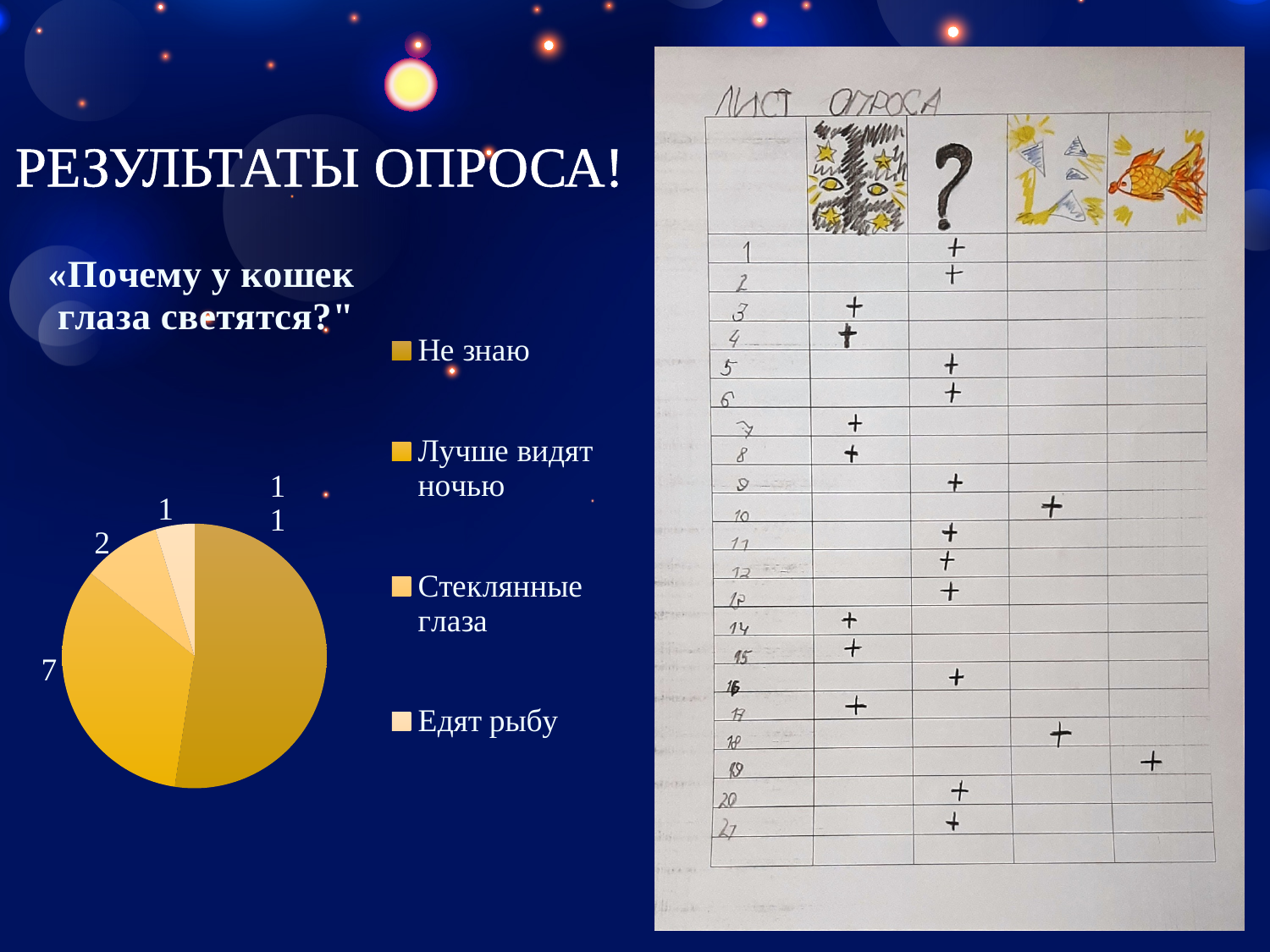
How many slices does the pie chart have? 4 What is the value for "Стеклянные глаза" in the pie chart? 2 What survey question is the pie chart about? «Почему у кошек глаза светятся?» What is the difference between the values for "Лучше видят ночью" and "Стеклянные глаза"? 5 What kind of chart is shown on the slide? pie chart What is the value for "Едят рыбу" in the pie chart? 1 Which is larger in the pie chart: "Лучше видят ночью" or "Стеклянные глаза"? Лучше видят ночью What is the value for "Не знаю" in the pie chart? 11 Which category has the smallest slice in the pie chart? Едят рыбу Which category has the largest slice in the pie chart? Не знаю How many entries does the legend of the pie chart list? 4 What is the value for "Лучше видят ночью" in the pie chart? 7